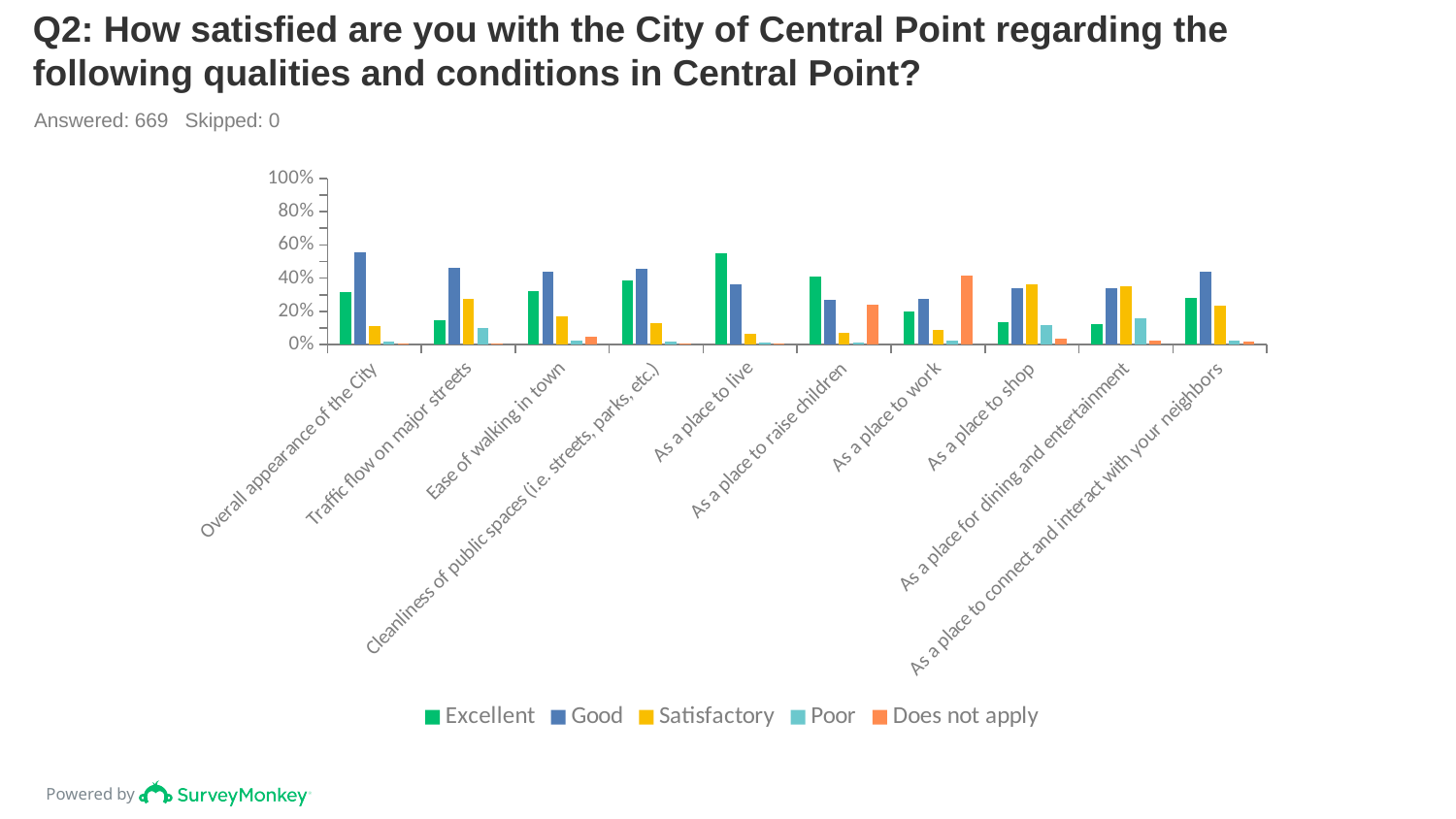
How many categories are shown along the x axis? 10 What colour represents the Excellent series in the legend? Green Is the Excellent value for "As a place for dining and entertainment" greater or less than 20%? less Which category has the highest Excellent value? As a place to live For "Traffic flow on major streets", which is larger: the Excellent value or the Good value? Good How many series does the legend list? 5 Which category has the highest Does not apply value? As a place to work Is the Excellent value for "As a place to live" greater or less than 40%? greater Is the Good value for "Overall appearance of the City" greater or less than 40%? greater For "As a place to live", which is larger: the Excellent value or the Good value? Excellent What kind of chart is shown on the slide? Bar chart